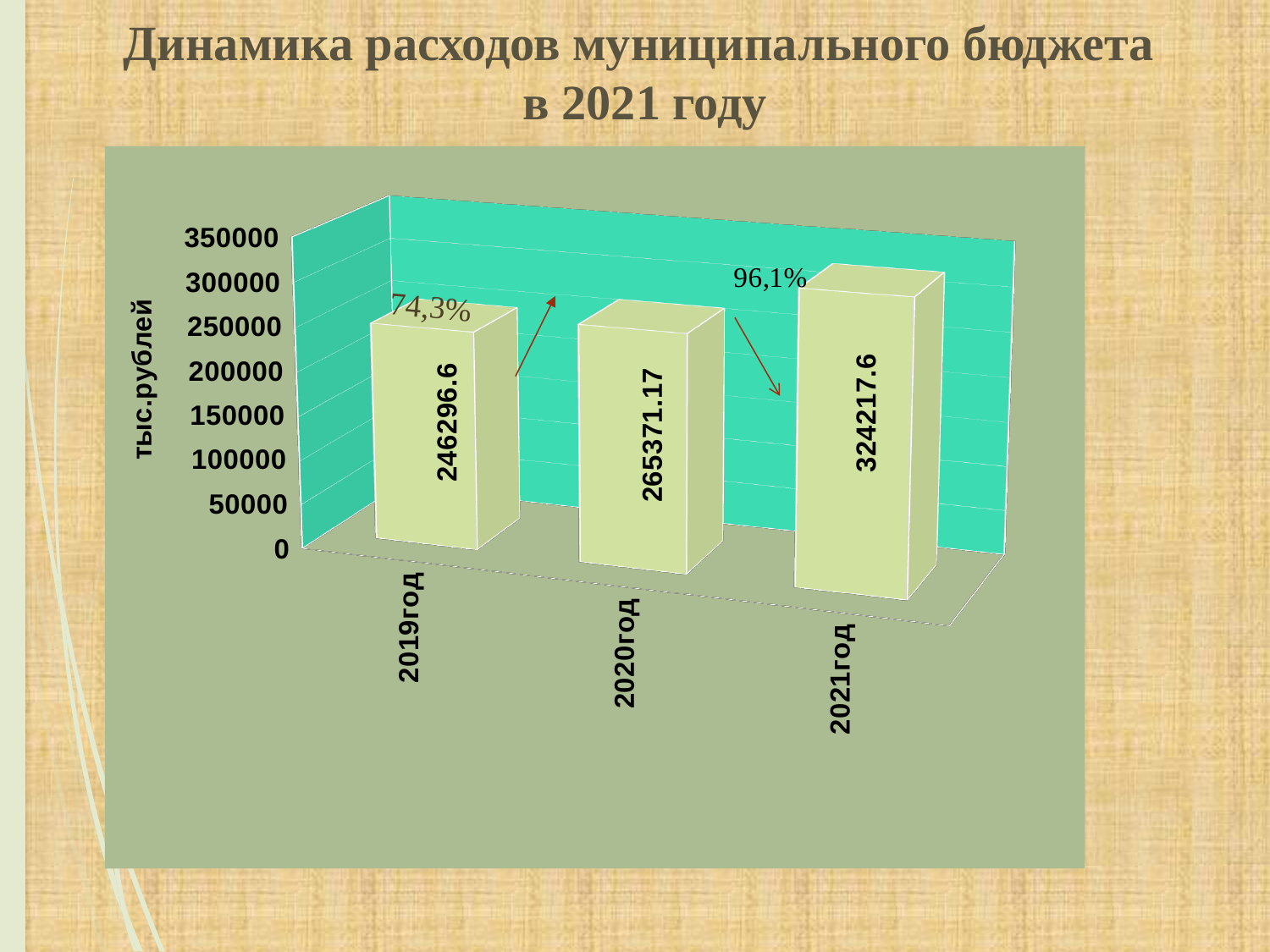
What is the difference between the values for 2021год and 2019год? 77921.0 What kind of chart is shown on the slide? bar chart Which is larger, the value for 2020год or the value for 2021год? 2021год Which year has the lowest value? 2019год Which year has the highest value? 2021год How many years are shown on the chart? 3 Is the value for 2021год greater or less than 300000? greater What is the value for 2021год? 324217.6 What is the value for 2019год? 246296.6 What is the value for 2020год? 265371.17 What is the difference between the values for 2020год and 2019год? 19074.57 Do the values rise or fall from 2019год to 2021год? rise